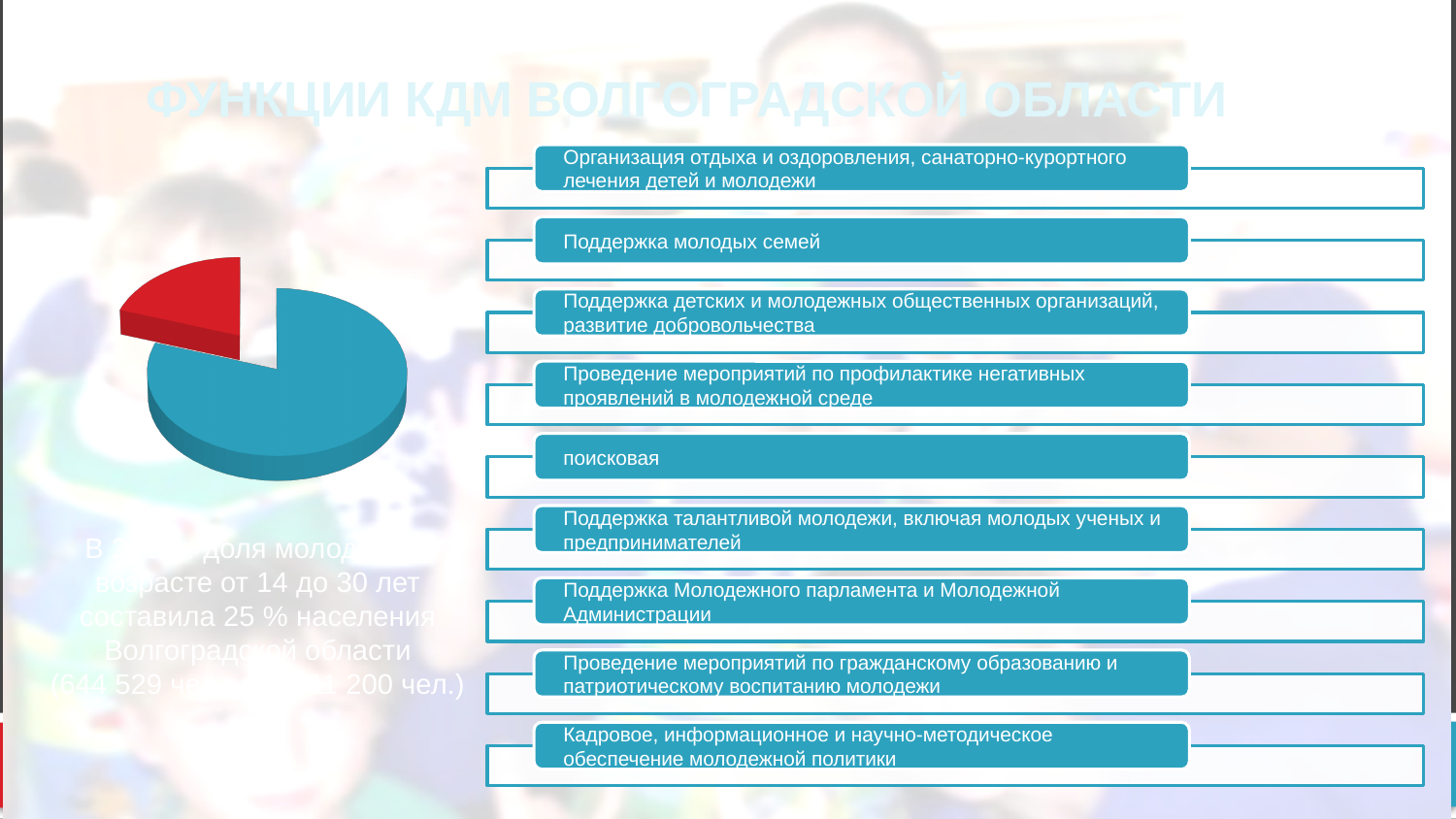
Does the red slice cover more or less than half of the pie chart? less What colour is the largest slice of the pie chart? blue How many slices does the pie chart have? 2 Which slice of the pie chart is pulled out (exploded) from the rest of the pie? the red slice What kind of chart is shown on the left of the slide? pie chart What colour is the smallest slice of the pie chart? red Is the pie chart drawn in 3D or flat 2D? 3D Which slice of the pie chart is larger, the blue one or the red one? the blue one